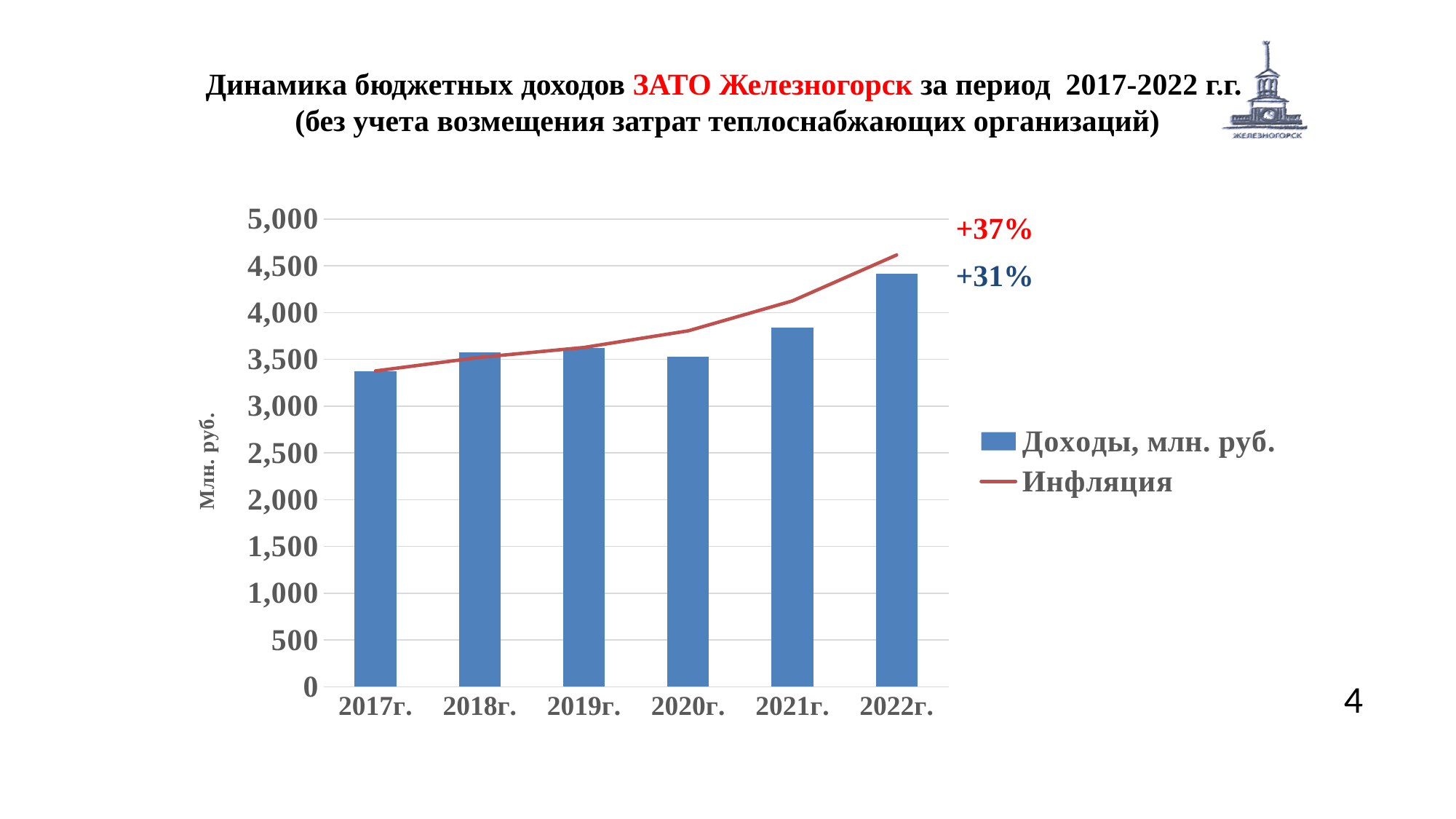
Which year has the larger Доходы bar, 2020г. or 2021г.? 2021г. How many series does the chart legend list? 2 Is the value of Доходы for 2017г. greater or less than 3,500? less Is the value of Доходы for 2022г. greater or less than 4,000? greater Is the value of Доходы for 2021г. greater or less than 3,500? greater What is the label of the vertical axis of the chart? Млн. руб. Which year has the lowest bar for Доходы, млн. руб.? 2017г. How many years are shown on the x axis of the chart? 6 Does the Инфляция line rise or fall from 2017г. to 2022г.? Rises Which year has the highest bar for Доходы, млн. руб.? 2022г. What kind of chart is shown on the slide? A bar chart with a line